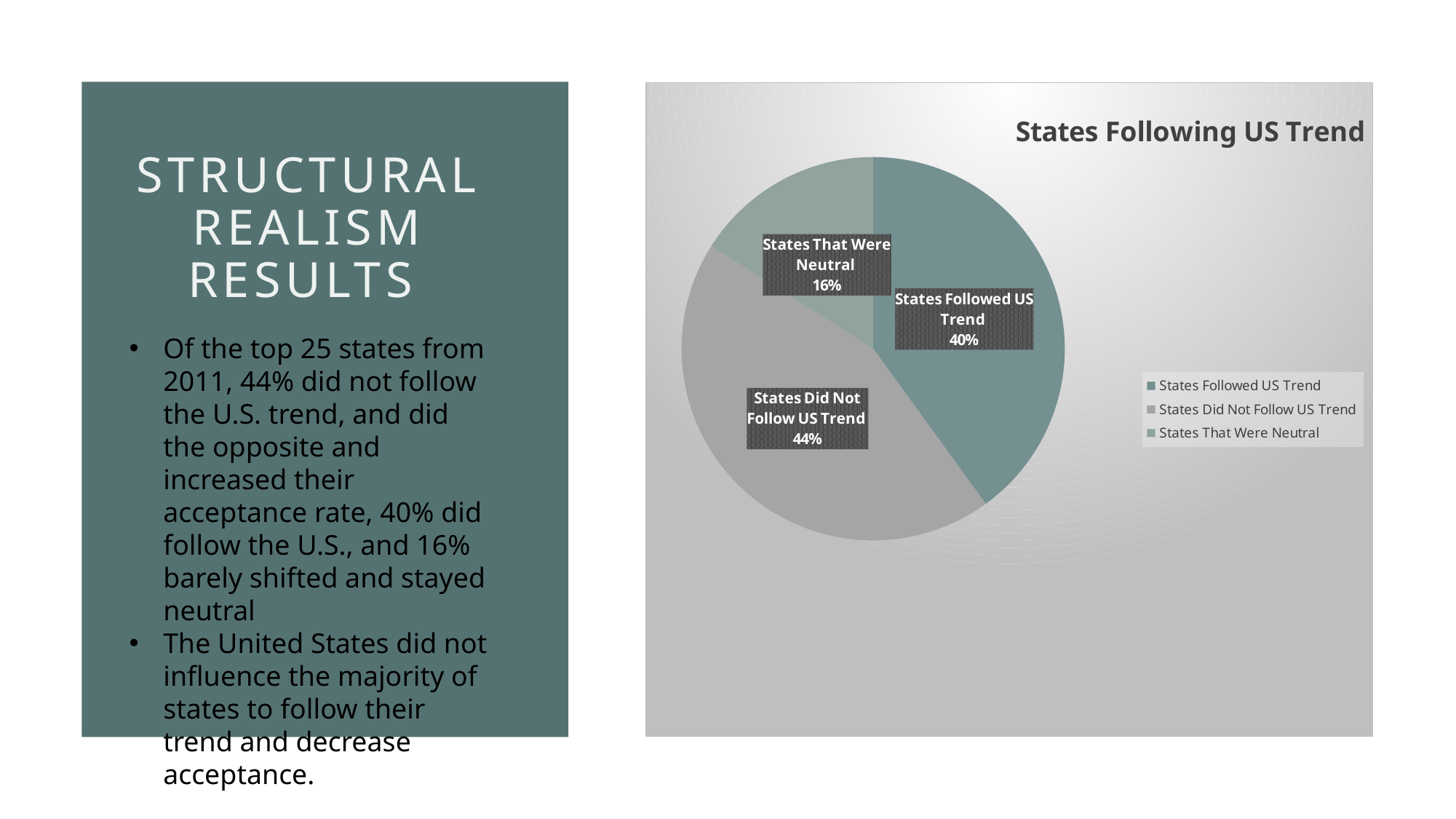
What percentage of states followed the US trend according to the chart? 40% Which is larger: the share for States Followed US Trend or States That Were Neutral? States Followed US Trend Which category has the largest share of the pie? States Did Not Follow US Trend What is the title of the chart? States Following US Trend How many entries does the legend list? 3 What percentage of states were neutral? 16% What percentage of states did not follow the US trend? 44% What is the difference in percentage points between States Did Not Follow US Trend and States Followed US Trend? 4 How many slices does the pie chart have? 3 What is the combined share of States Followed US Trend and States That Were Neutral? 56% Which category has the smallest share of the pie? States That Were Neutral What type of chart is shown on the slide? Pie chart